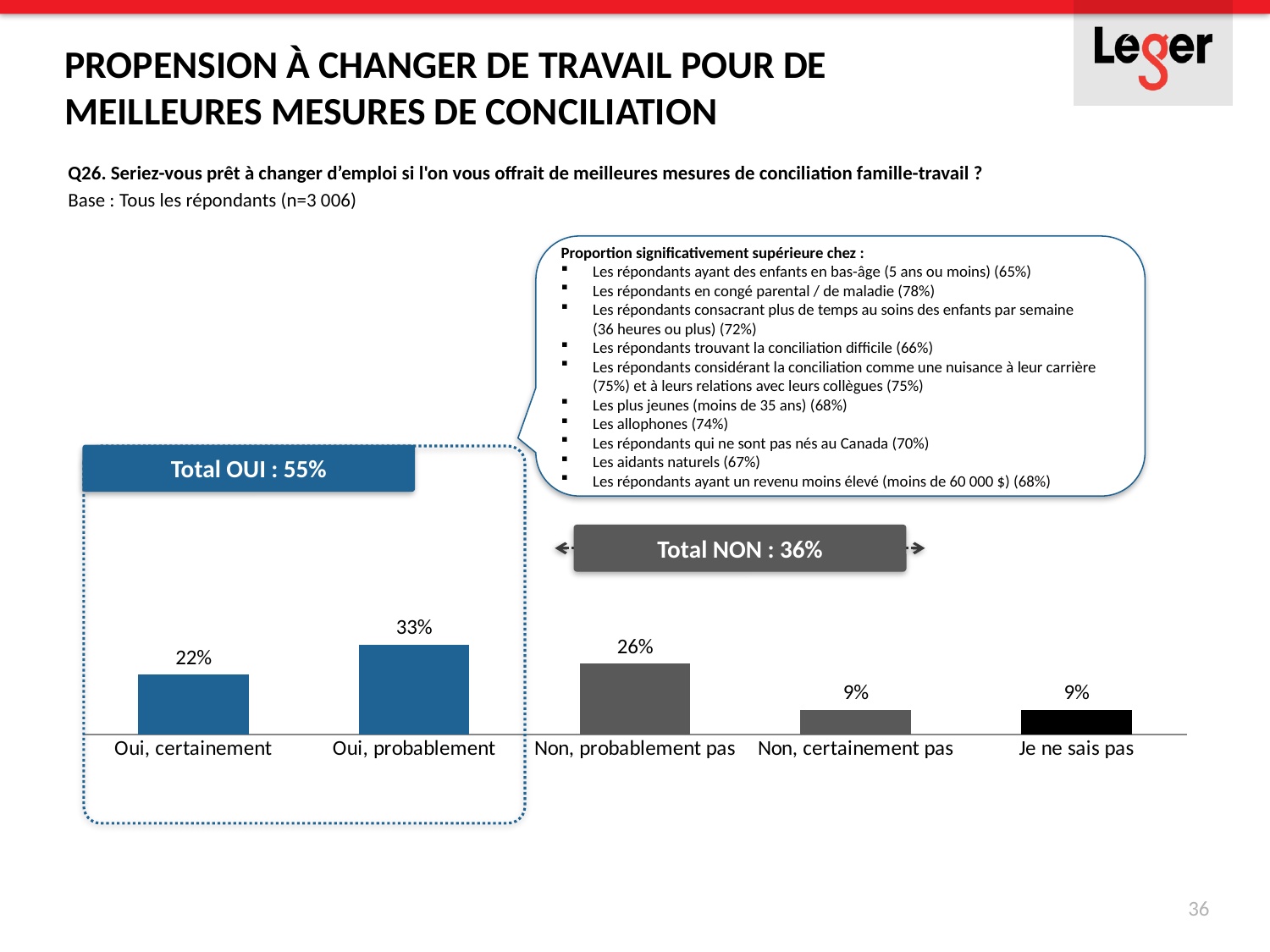
What kind of chart is shown on the slide? Bar chart Which category has the highest value? Oui, probablement What is the value for "Oui, certainement"? 22% What is the "Total NON" value shown on the slide? 36% What is the value for "Non, probablement pas"? 26% Which is larger, "Oui, probablement" or "Non, probablement pas"? Oui, probablement What is the value for "Oui, probablement"? 33% What is the difference between "Oui, probablement" and "Oui, certainement"? 11% What is the value for "Je ne sais pas"? 9% What is the "Total OUI" value shown on the slide? 55% What is the difference between "Non, probablement pas" and "Non, certainement pas"? 17% How many categories are shown in the chart? 5